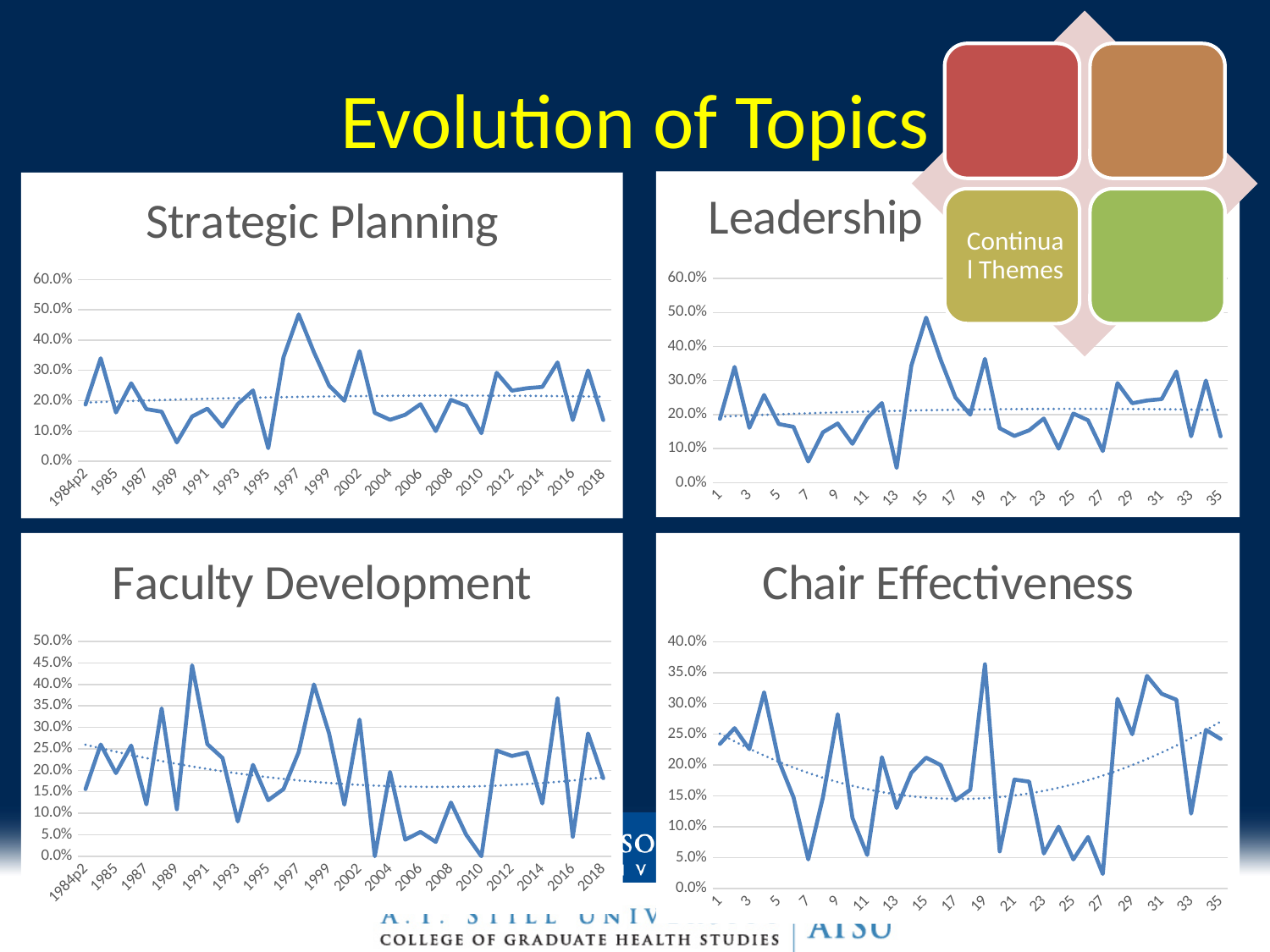
In the Strategic Planning chart, is the value for 1995 greater or less than 10.0%? less In the Strategic Planning chart, is the value for 1997 greater or less than 40.0%? greater What kind of chart is the Strategic Planning chart? line chart In the Leadership chart, is the value at point 15 greater or less than 40.0%? greater In the Leadership chart, how many points are plotted along the x axis? 35 What is the highest value shown on the y axis of the Faculty Development chart? 50.0% What is the title of the chart in the bottom-right of the slide? Chair Effectiveness How many charts are shown on the slide? 4